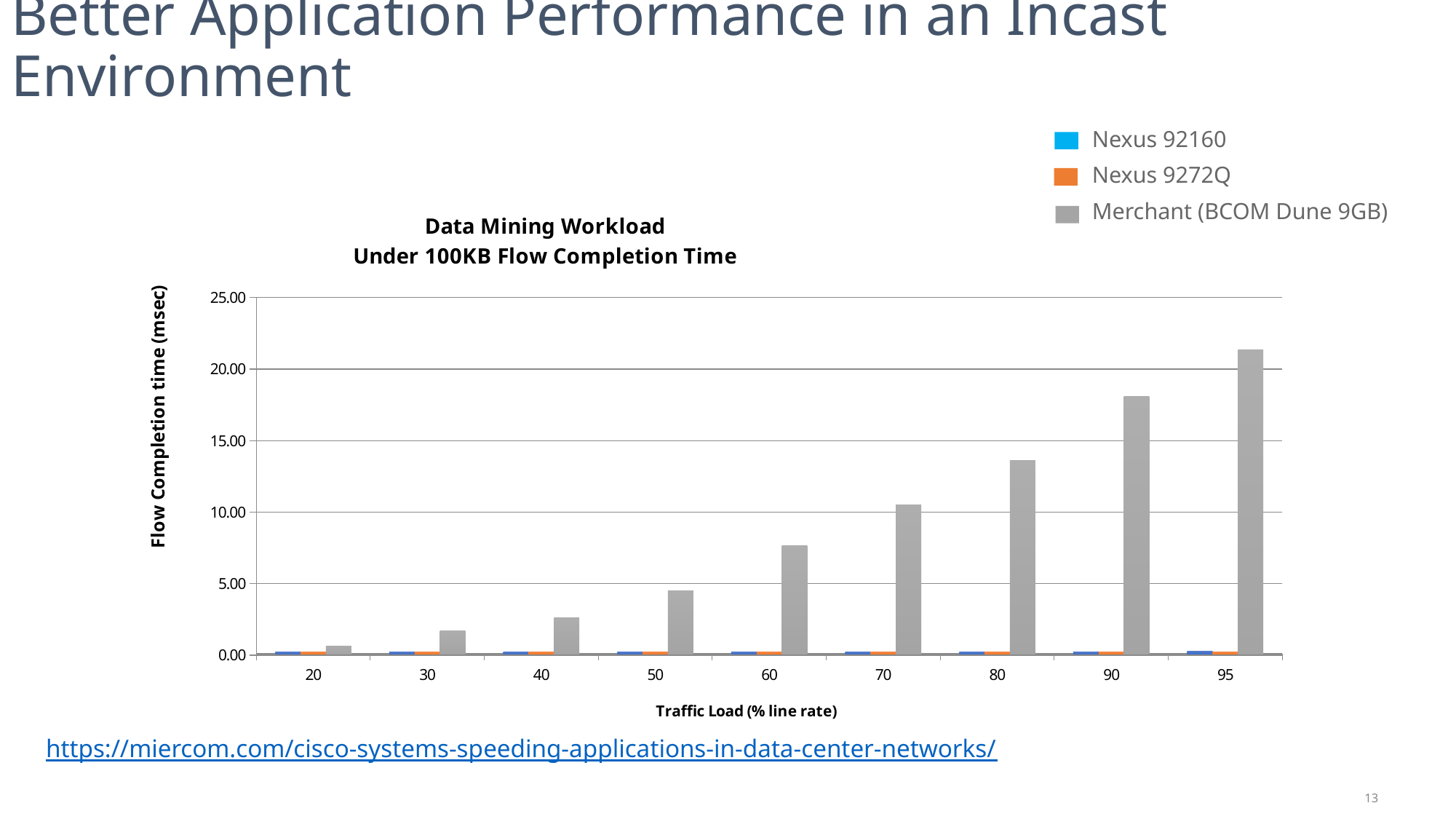
Is the Merchant (BCOM Dune 9GB) value at traffic load 95 greater or less than 20.00? greater What kind of chart is shown on the slide? Bar chart Does the Merchant (BCOM Dune 9GB) flow completion time rise or fall as traffic load increases? Rise How many series does the legend list? 3 What is the label of the y axis? Flow Completion time (msec) Is the Merchant (BCOM Dune 9GB) value at traffic load 80 greater or less than 15.00? less At which traffic load is the Merchant (BCOM Dune 9GB) flow completion time lowest? 20 At traffic load 95, which has the larger flow completion time: Nexus 92160 or Merchant (BCOM Dune 9GB)? Merchant (BCOM Dune 9GB) Is the Merchant (BCOM Dune 9GB) value at traffic load 60 greater or less than 10.00? less At which traffic load is the Merchant (BCOM Dune 9GB) flow completion time highest? 95 How many traffic load categories are shown on the x axis? 9